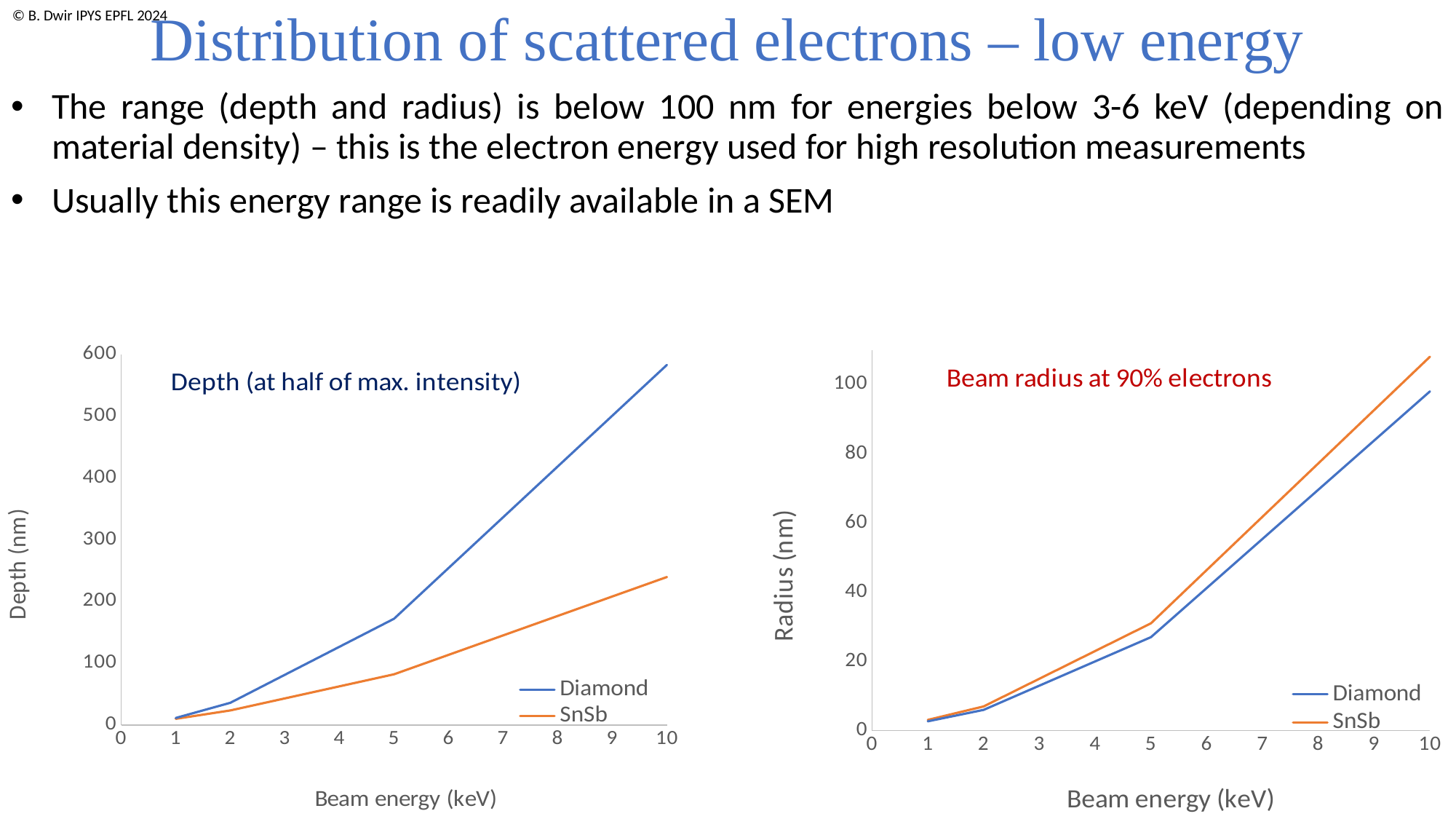
In the 'Depth (at half of max. intensity)' chart, is the Diamond value at 5 keV greater or less than 100? greater How many series does the legend of the 'Beam radius at 90% electrons' chart list? 2 What is the y-axis label of the 'Depth (at half of max. intensity)' chart? Depth (nm) What kind of chart is the 'Depth (at half of max. intensity)' chart on the left? line chart In the 'Depth (at half of max. intensity)' chart, is the Diamond value at 10 keV greater or less than 500? greater In the 'Depth (at half of max. intensity)' chart, which series has the larger value at 10 keV, Diamond or SnSb? Diamond What is the x-axis label of the 'Beam radius at 90% electrons' chart? Beam energy (keV) In the 'Beam radius at 90% electrons' chart, is the SnSb value at 10 keV greater or less than 100? greater In the 'Beam radius at 90% electrons' chart, do the values rise or fall as beam energy increases? rise In the 'Beam radius at 90% electrons' chart, which series has the larger value at 10 keV, Diamond or SnSb? SnSb